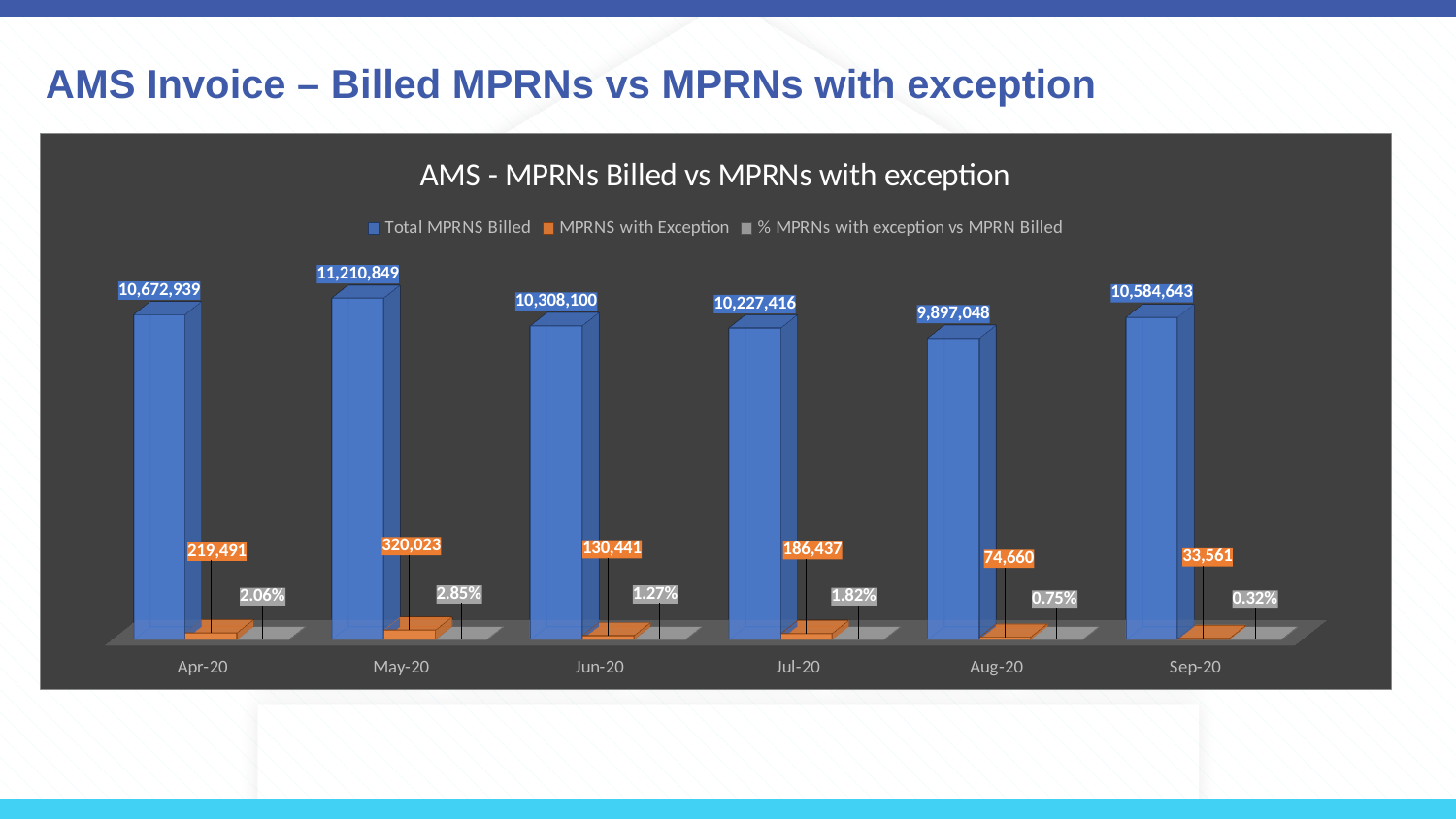
Which is larger, the Total MPRNS Billed for Jun-20 or for Sep-20? Sep-20 What is the % MPRNs with exception vs MPRN Billed for Sep-20? 0.32% How many series does the legend list? 3 How many months are shown on the x axis? 6 Which month has the lowest MPRNS with Exception? Sep-20 What is the difference in MPRNS with Exception between May-20 and Apr-20? 100,532 Which month has the lowest Total MPRNS Billed? Aug-20 What kind of chart is shown on the slide? Bar chart Does the % MPRNs with exception vs MPRN Billed rise or fall from Jul-20 to Sep-20? Fall What is the MPRNS with Exception value for Jul-20? 186,437 Which month has the highest Total MPRNS Billed? May-20 What is the Total MPRNS Billed value for May-20? 11,210,849